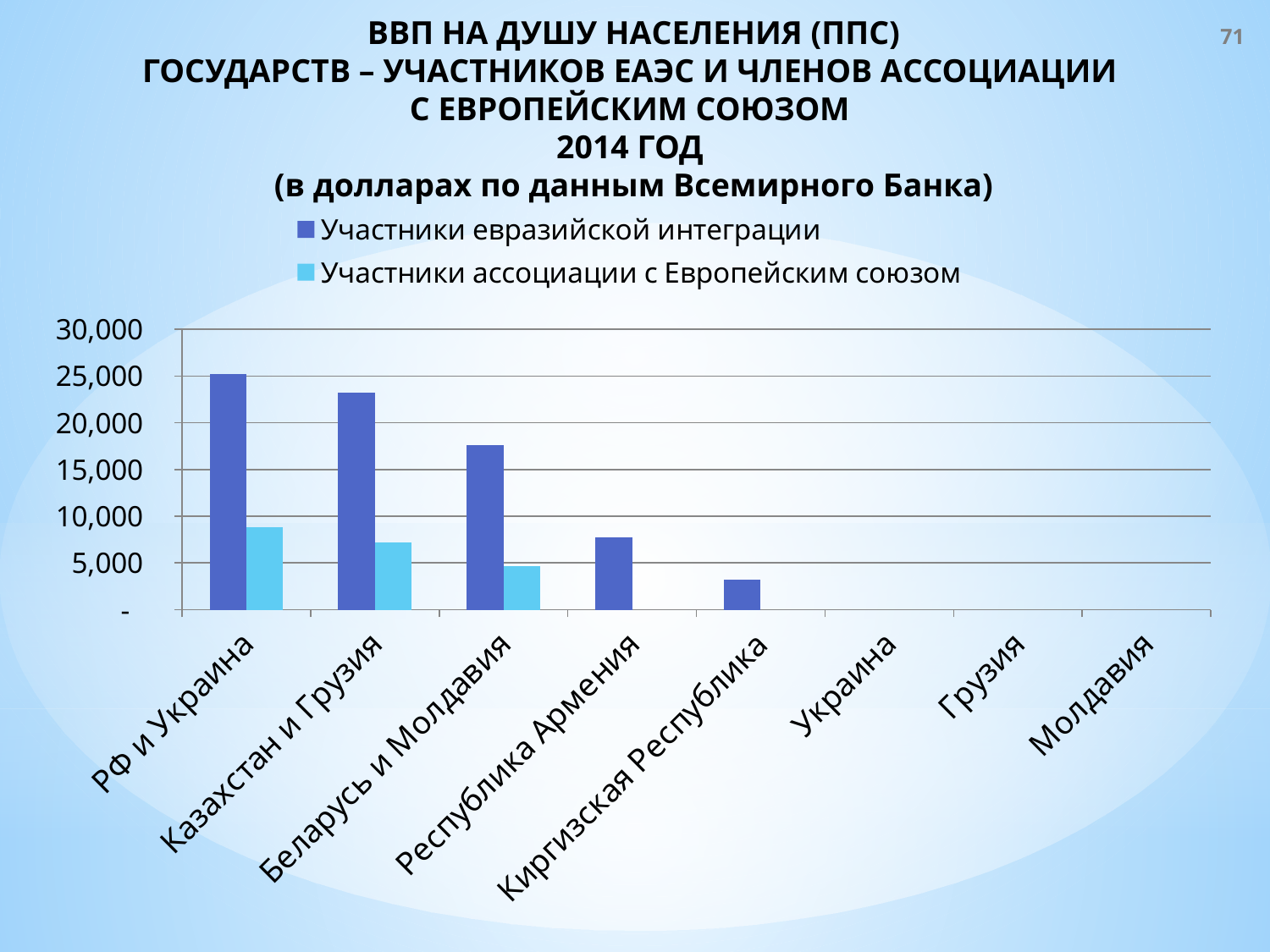
Do the values for 'Участники евразийской интеграции' rise or fall from РФ и Украина to Киргизская Республика along the x axis? fall Among the categories with a visible bar for 'Участники евразийской интеграции', which has the lowest value? Киргизская Республика Is the value for 'Участники евразийской интеграции' for Республика Армения greater or less than 10,000? less For РФ и Украина, which series has the larger value: 'Участники евразийской интеграции' or 'Участники ассоциации с Европейским союзом'? Участники евразийской интеграции How many series does the legend list? 2 Is the value for 'Участники евразийской интеграции' for Киргизская Республика greater or less than 5,000? less Is the value for 'Участники евразийской интеграции' for Беларусь и Молдавия greater or less than 20,000? less Which category has the highest value for the series 'Участники евразийской интеграции'? РФ и Украина What kind of chart is shown on the slide? bar chart How many categories are shown on the x axis? 8